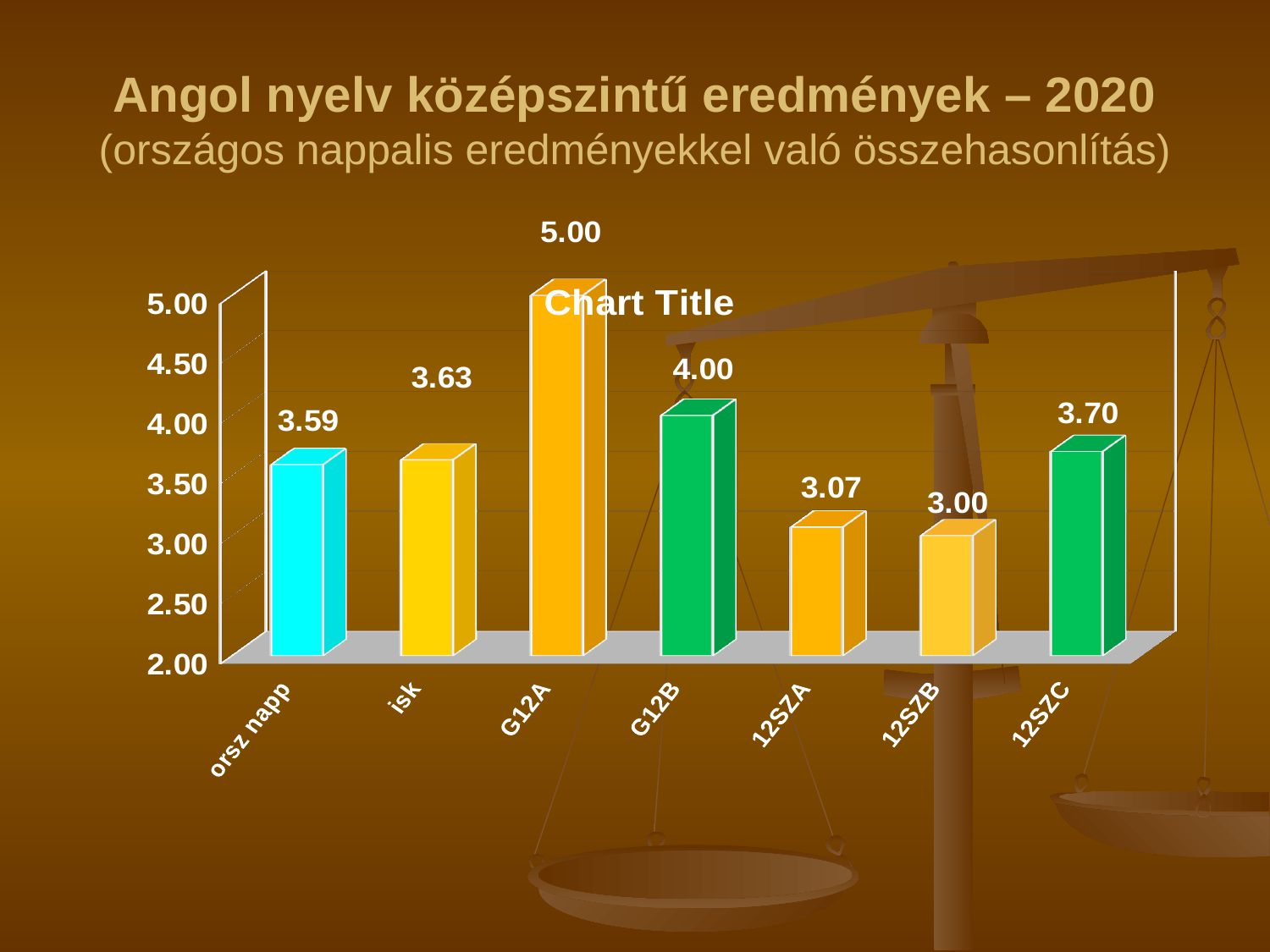
What is the value for orsz napp? 3.59 Is the value for 12SZA greater or less than 3.50? less What is the value for 12SZB? 3.00 What kind of chart is shown on the slide? bar chart How many categories are shown on the x axis? 7 Which category has the highest value? G12A Which is larger, the value for isk or the value for 12SZC? 12SZC What is the difference between the values for G12B and 12SZA? 0.93 What is the title printed inside the chart area? Chart Title What is the value for 12SZC? 3.70 What is the value for G12A? 5.00 Which category has the lowest value? 12SZB